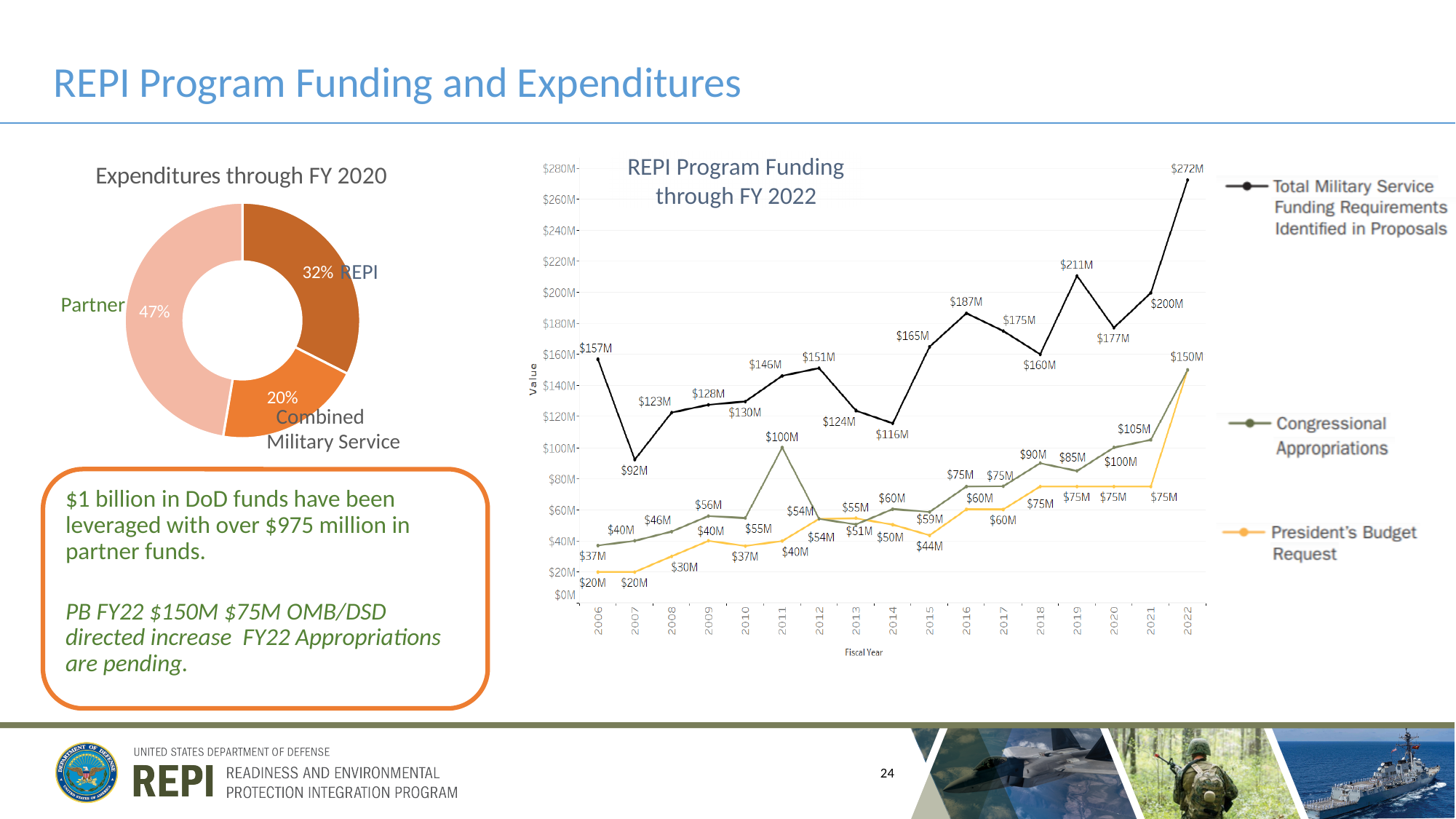
In the 'REPI Program Funding through FY 2022' chart, how many series does the legend list? 3 In the 'REPI Program Funding through FY 2022' chart, what is the Congressional Appropriations value for 2011? $100M What kind of chart is 'REPI Program Funding through FY 2022'? Line chart In the 'REPI Program Funding through FY 2022' chart, in which year is the Total Military Service Funding Requirements value lowest? 2007 In the 'Expenditures through FY 2020' donut chart, what share is attributed to Combined Military Service? 20% In the 'REPI Program Funding through FY 2022' chart, what is the President's Budget Request value for 2008? $30M In the 'Expenditures through FY 2020' donut chart, how many categories are shown? 3 In the 'REPI Program Funding through FY 2022' chart, which is larger in 2019: Congressional Appropriations or President's Budget Request? Congressional Appropriations In the 'Expenditures through FY 2020' donut chart, which category has the largest share? Partner In the 'Expenditures through FY 2020' donut chart, what share of expenditures is attributed to Partner? 47% In the 'REPI Program Funding through FY 2022' chart, what is the difference between Total Military Service Funding Requirements and Congressional Appropriations in 2022? $122M In the 'REPI Program Funding through FY 2022' chart, what is the Total Military Service Funding Requirements value for 2022? $272M